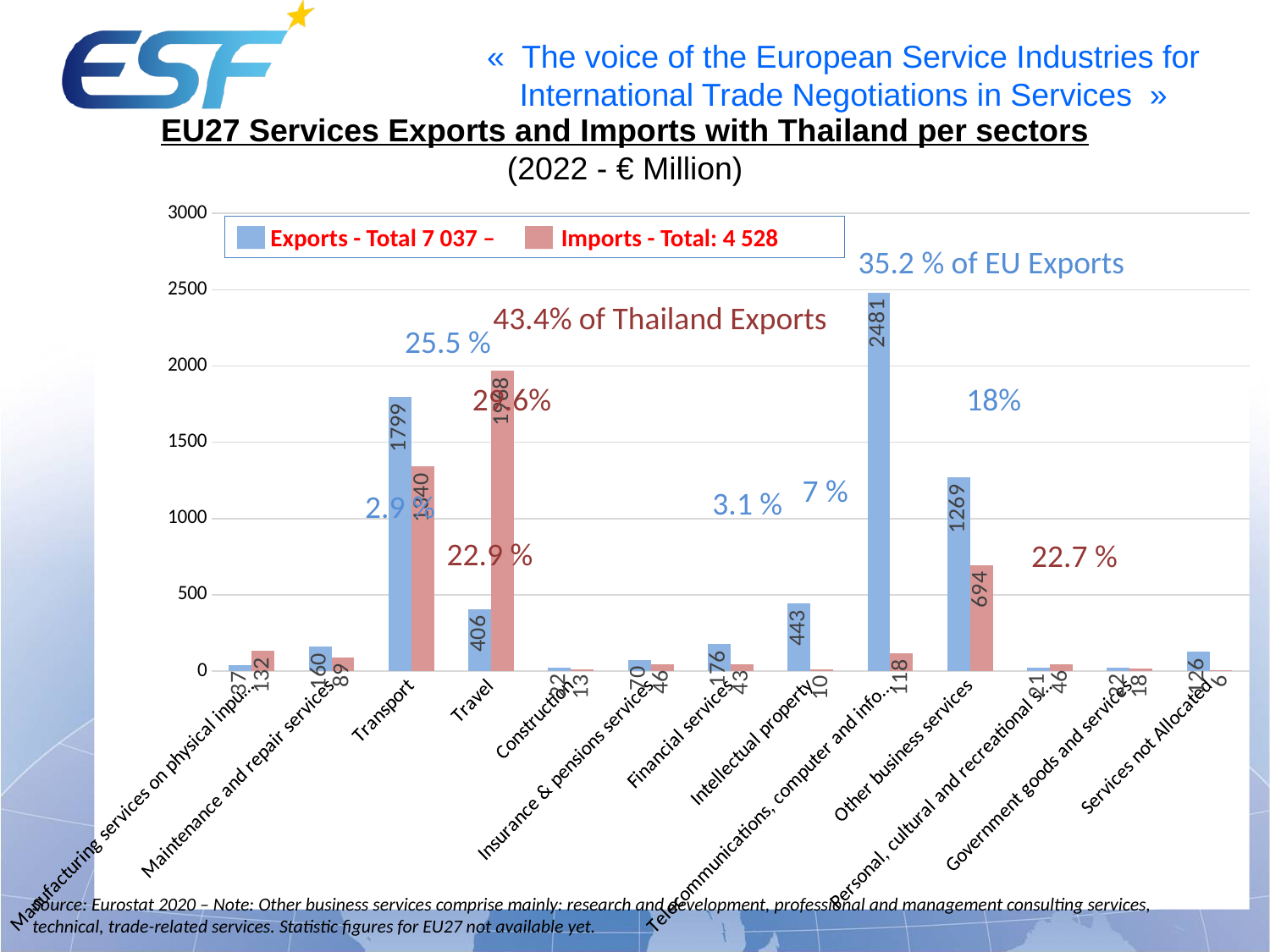
Which sector has the highest Exports value? Telecommunications, computer and info... What is the value of Imports for Other business services? 694 How many sector categories are plotted along the x axis? 13 What is the value of Exports for Transport? 1799 Is the Imports value for Travel greater or less than 1500? greater How many series does the legend list? 2 For Travel, which is larger, Exports or Imports? Imports What is the value of Exports for Telecommunications, computer and info...? 2481 What kind of chart is shown on the slide? Bar chart According to the legend, what is the total of Exports? 7 037 What is the difference between Exports and Imports for Transport? 459 What is the value of Imports for Intellectual property? 10